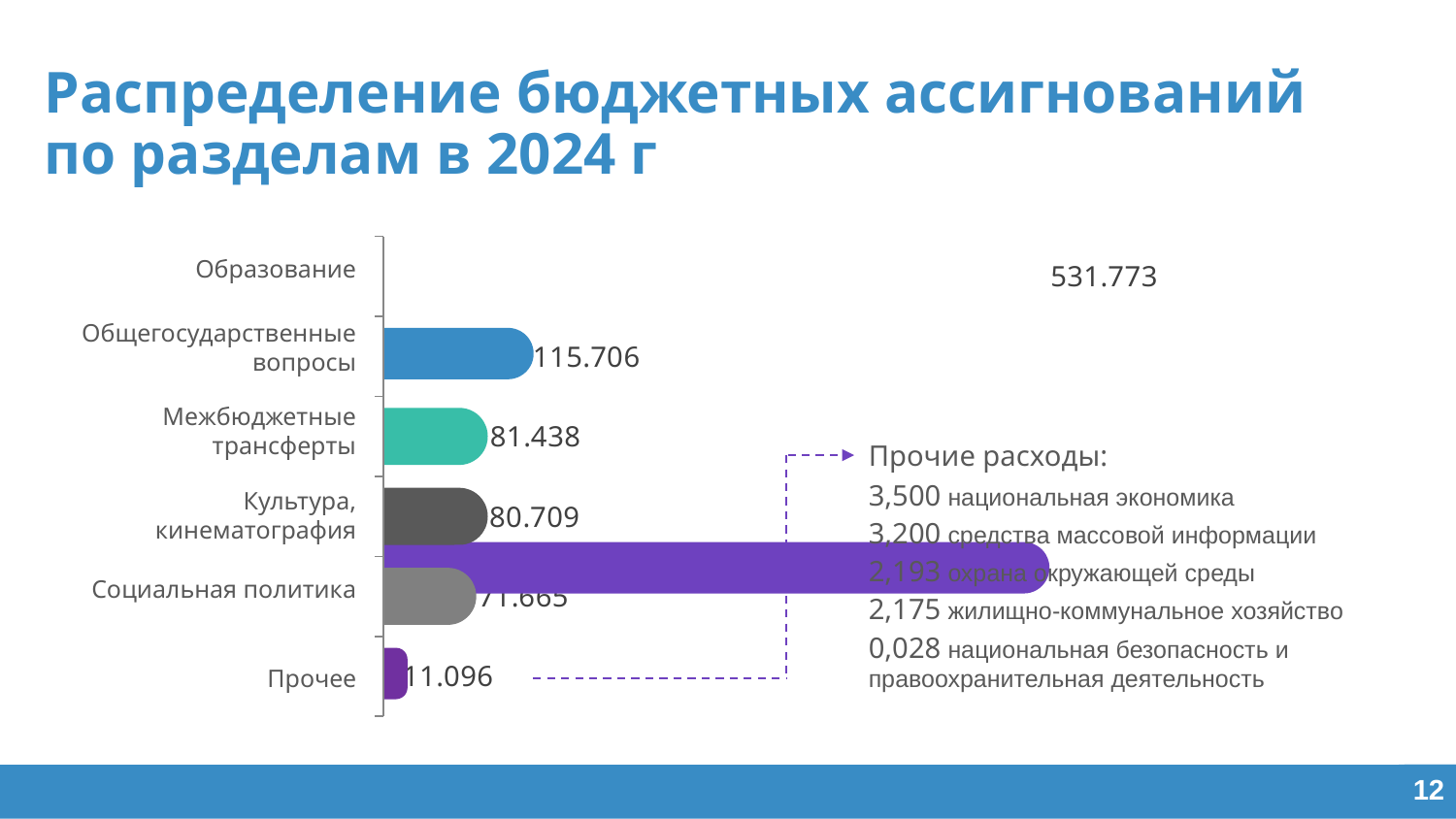
What is the value for Культура, кинематография? 80.709 What is the value for Образование? 531.773 What is the value for Прочее? 11.096 Which is larger, the value for Межбюджетные трансферты or the value for Культура, кинематография? Межбюджетные трансферты What is the title of the slide? Распределение бюджетных ассигнований по разделам в 2024 г What kind of chart is shown on the slide? Bar chart Which category has the lowest value? Прочее What is the value for Межбюджетные трансферты? 81.438 What is the value for Общегосударственные вопросы? 115.706 What is the difference between the values for Общегосударственные вопросы and Межбюджетные трансферты? 34.268 Which category has the highest value? Образование How many categories are shown on the chart? 6